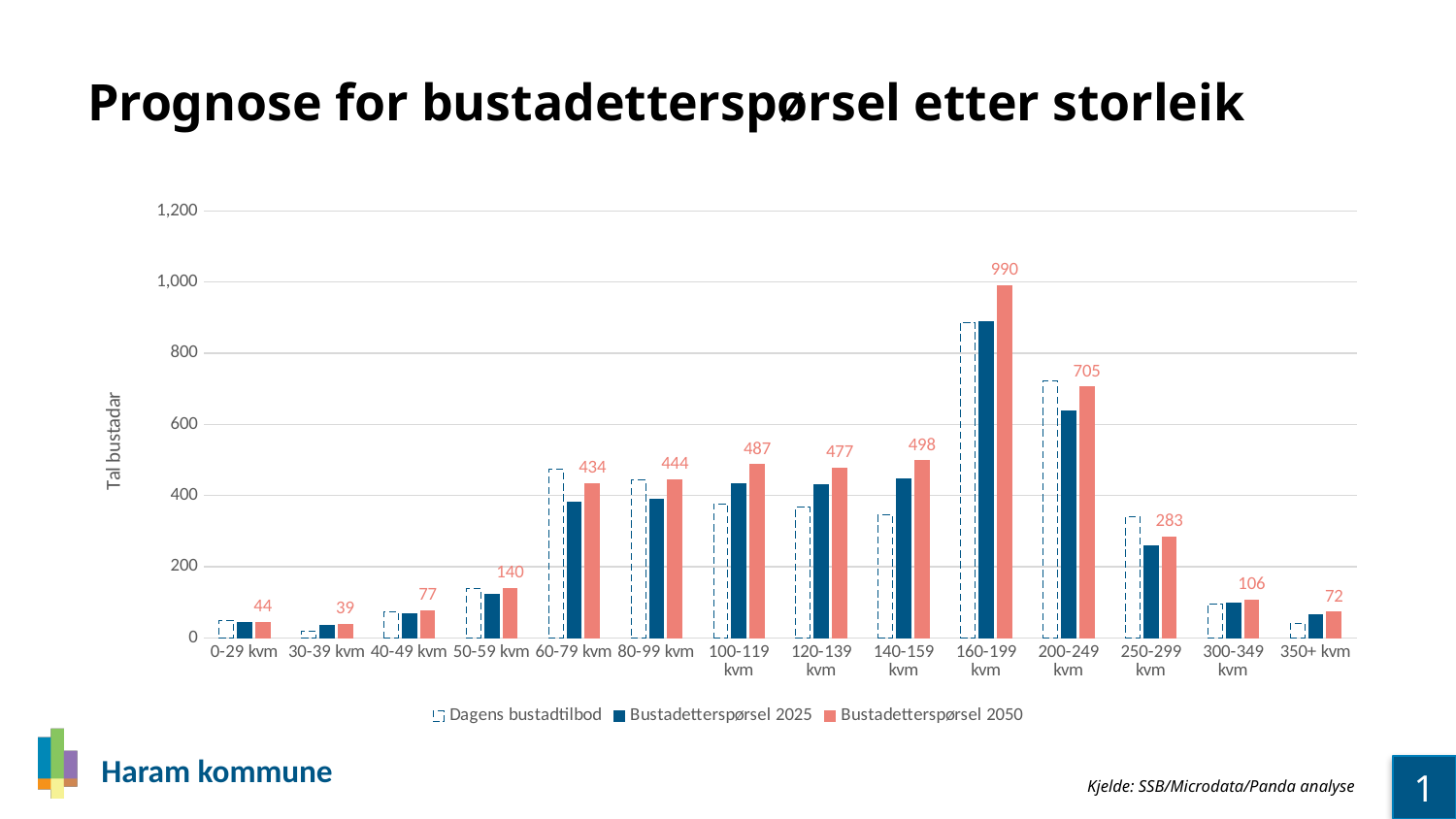
Which is larger for Bustadetterspørsel 2050: 140-159 kvm or 120-139 kvm? 140-159 kvm What is the Bustadetterspørsel 2050 value for 160-199 kvm? 990 What type of chart is shown on the slide? Bar chart Which size category has the highest Bustadetterspørsel 2050 value? 160-199 kvm How many series does the legend list? 3 How many size categories are shown on the x axis? 14 What is the Bustadetterspørsel 2050 value for 250-299 kvm? 283 Is the Dagens bustadtilbod value for 140-159 kvm greater or less than 400? less What is the difference between the Bustadetterspørsel 2050 values for 160-199 kvm and 200-249 kvm? 285 Which size category has the lowest Bustadetterspørsel 2050 value? 30-39 kvm Is the Bustadetterspørsel 2025 value for 200-249 kvm greater or less than 600? greater What is the Bustadetterspørsel 2050 value for 50-59 kvm? 140